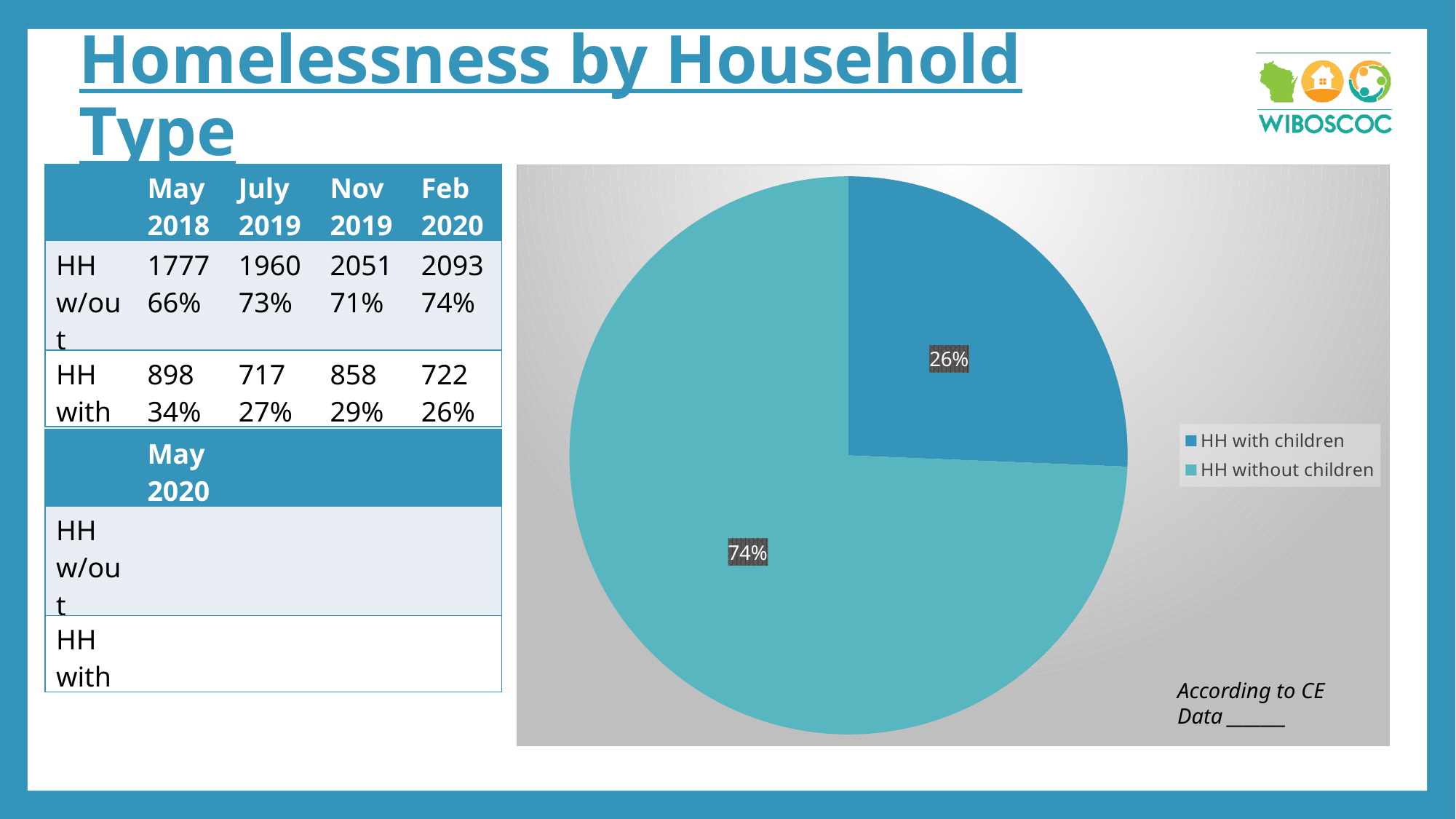
How many entries does the pie chart's legend list? 2 How many slices does the pie chart have? 2 What is the data label shown on the darker blue slice of the pie chart? 26% What kind of chart is shown on the slide? pie chart What share of the pie does HH with children represent? 26% Which legend entry is shown with the lighter teal colour in the pie chart? HH without children Which slice of the pie chart is the smallest? HH with children What share of the pie does HH without children represent? 74% Which slice of the pie chart is the largest? HH without children What is the difference in percentage points between the HH without children slice and the HH with children slice? 48 What is the title of the slide containing the pie chart? Homelessness by Household Type Which is larger in the pie chart, HH with children or HH without children? HH without children